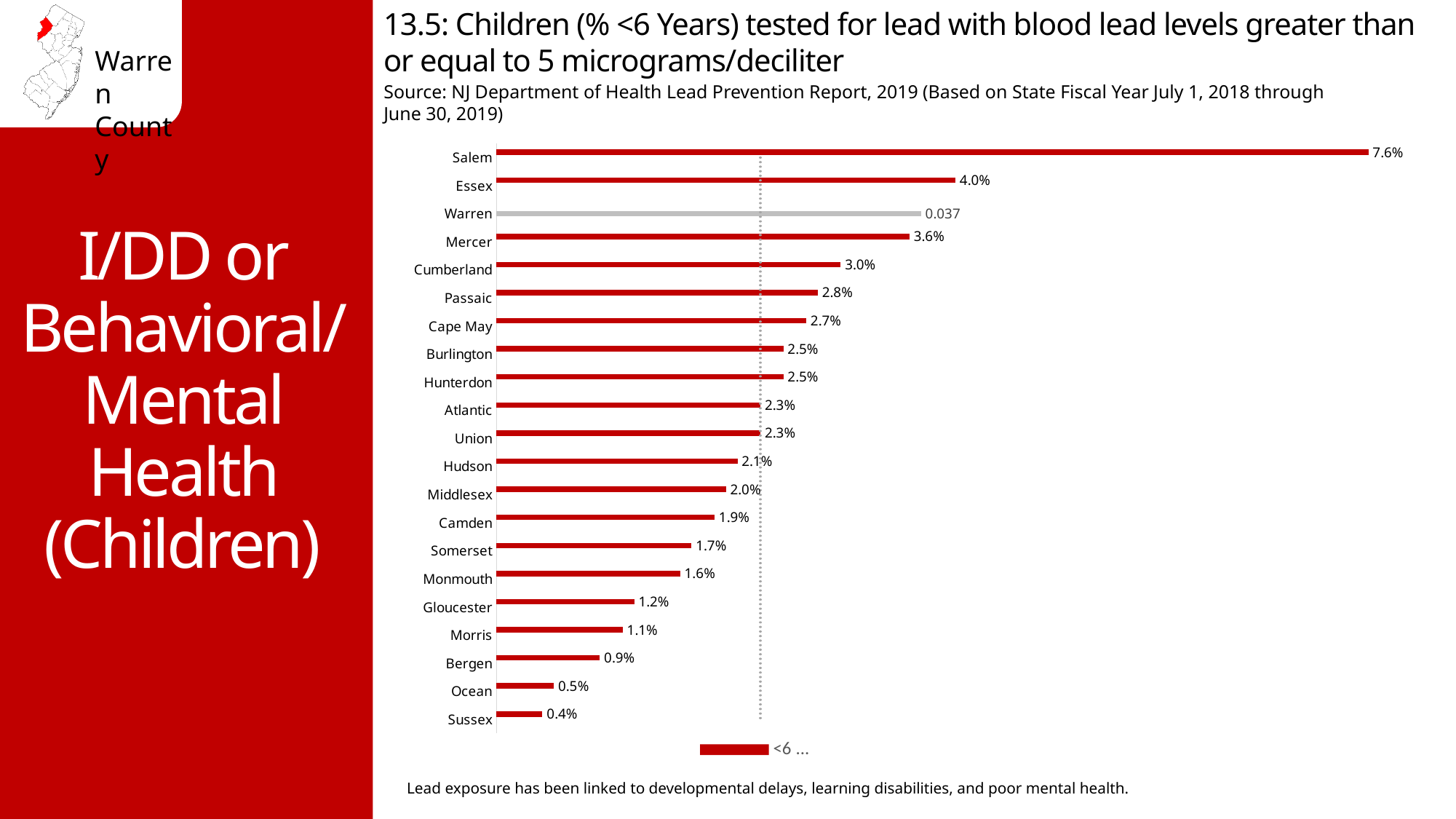
Which county has the lowest value? Sussex Which is larger, the value for Passaic or the value for Camden? Passaic How many counties are shown in the chart? 21 What type of chart is shown on the slide? Bar chart Which county's bar is drawn in gray rather than red? Warren What value is shown for Warren? 0.037 What is the value for Salem? 7.6% What is the value for Bergen? 0.9% Which county has the highest value? Salem What is the difference between the values for Salem and Essex? 3.6% What is the difference between the values for Mercer and Cumberland? 0.6% What is the value for Cumberland? 3.0%